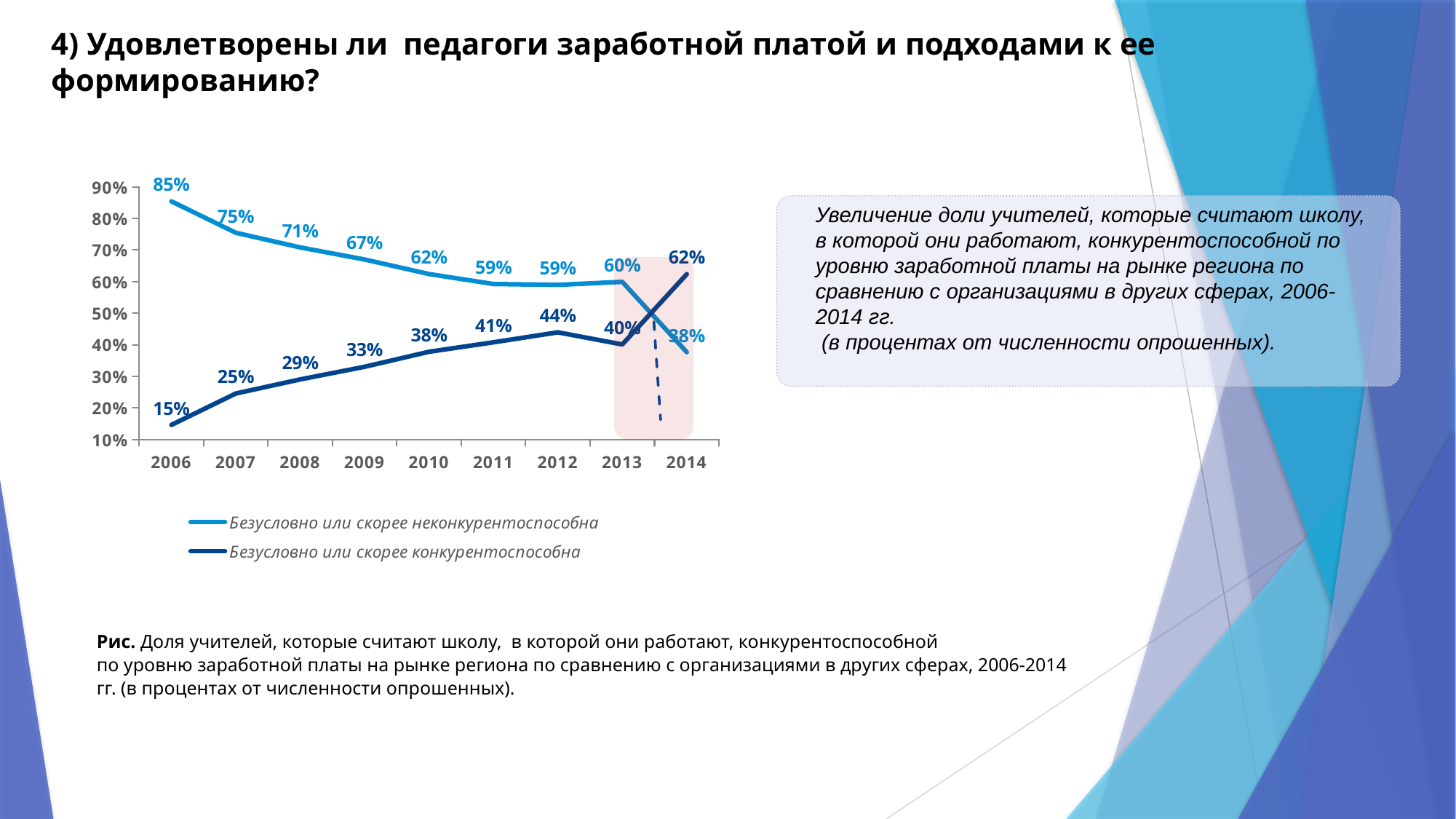
How many years are shown on the x axis? 9 What is the difference between the 'Безусловно или скорее неконкурентоспособна' and 'Безусловно или скорее конкурентоспособна' values in 2006? 70% Which series has the larger value in 2012: 'Безусловно или скорее неконкурентоспособна' or 'Безусловно или скорее конкурентоспособна'? Безусловно или скорее неконкурентоспособна In which year is the 'Безусловно или скорее неконкурентоспособна' series highest? 2006 How many series does the legend list? 2 What is the value for 'Безусловно или скорее конкурентоспособна' in 2014? 62% In which year is the 'Безусловно или скорее конкурентоспособна' series lowest? 2006 What is the value for 'Безусловно или скорее конкурентоспособна' in 2010? 38% What kind of chart is shown on the slide? line chart Does the 'Безусловно или скорее конкурентоспособна' series generally rise or fall from 2006 to 2012? rise Which series is drawn in the darker blue line? Безусловно или скорее конкурентоспособна What is the value for 'Безусловно или скорее неконкурентоспособна' in 2006? 85%